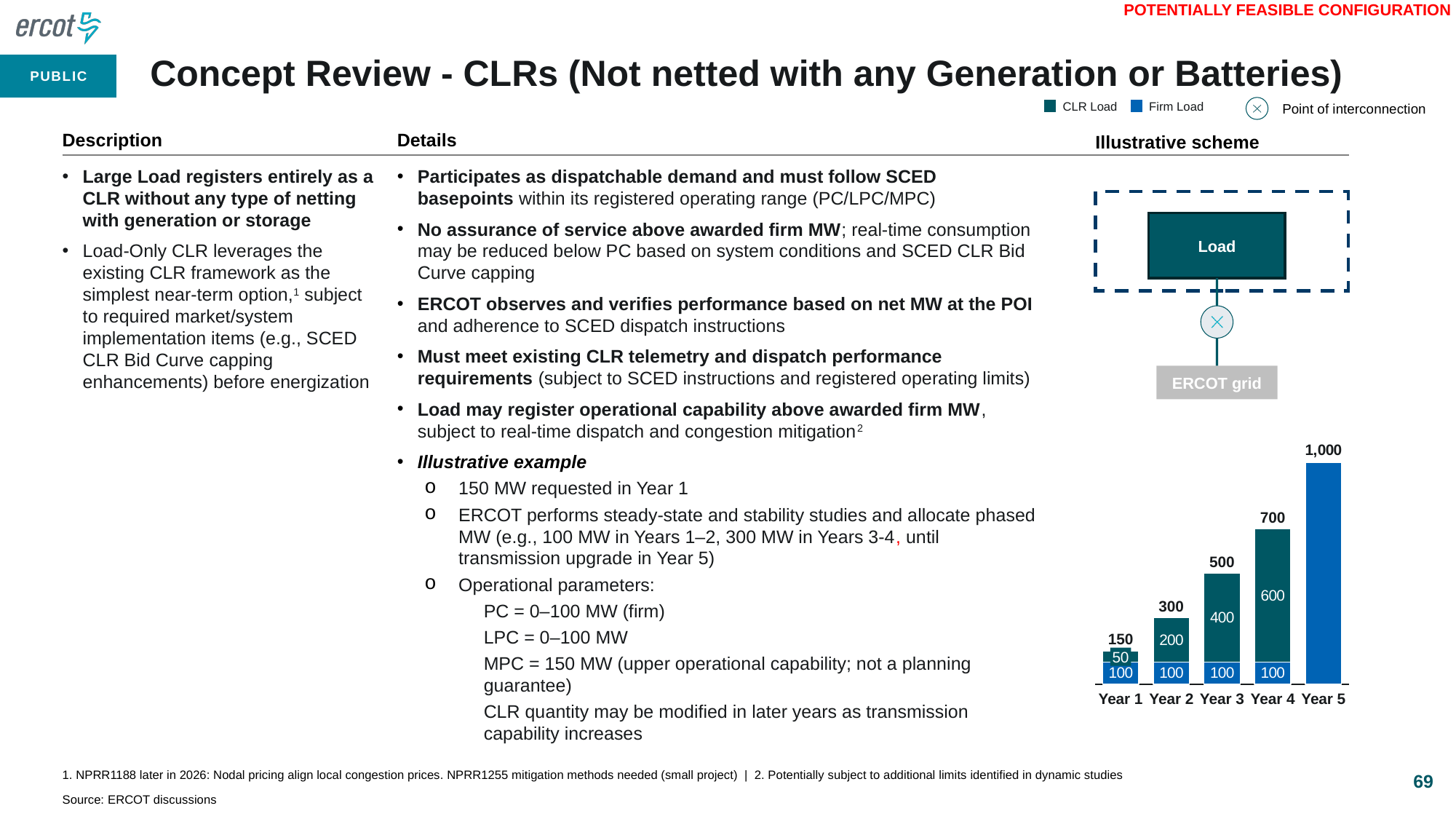
What is the difference between the total for Year 5 and the total for Year 4? 300 How many series does the legend list for the bar chart? 2 What is the CLR Load value for Year 2? 200 Which year has the highest total bar value? Year 5 What is the total value of the stacked bar for Year 3? 500 How many years are shown on the x axis of the bar chart? 5 What is the Firm Load value for Year 4? 100 What is the difference between the CLR Load values for Year 4 and Year 3? 200 Do the total bar values rise or fall from Year 1 to Year 5? rise Which year has the lowest total bar value? Year 1 Which is larger, the CLR Load value for Year 3 or the CLR Load value for Year 2? Year 3 What is the CLR Load value for Year 1? 50